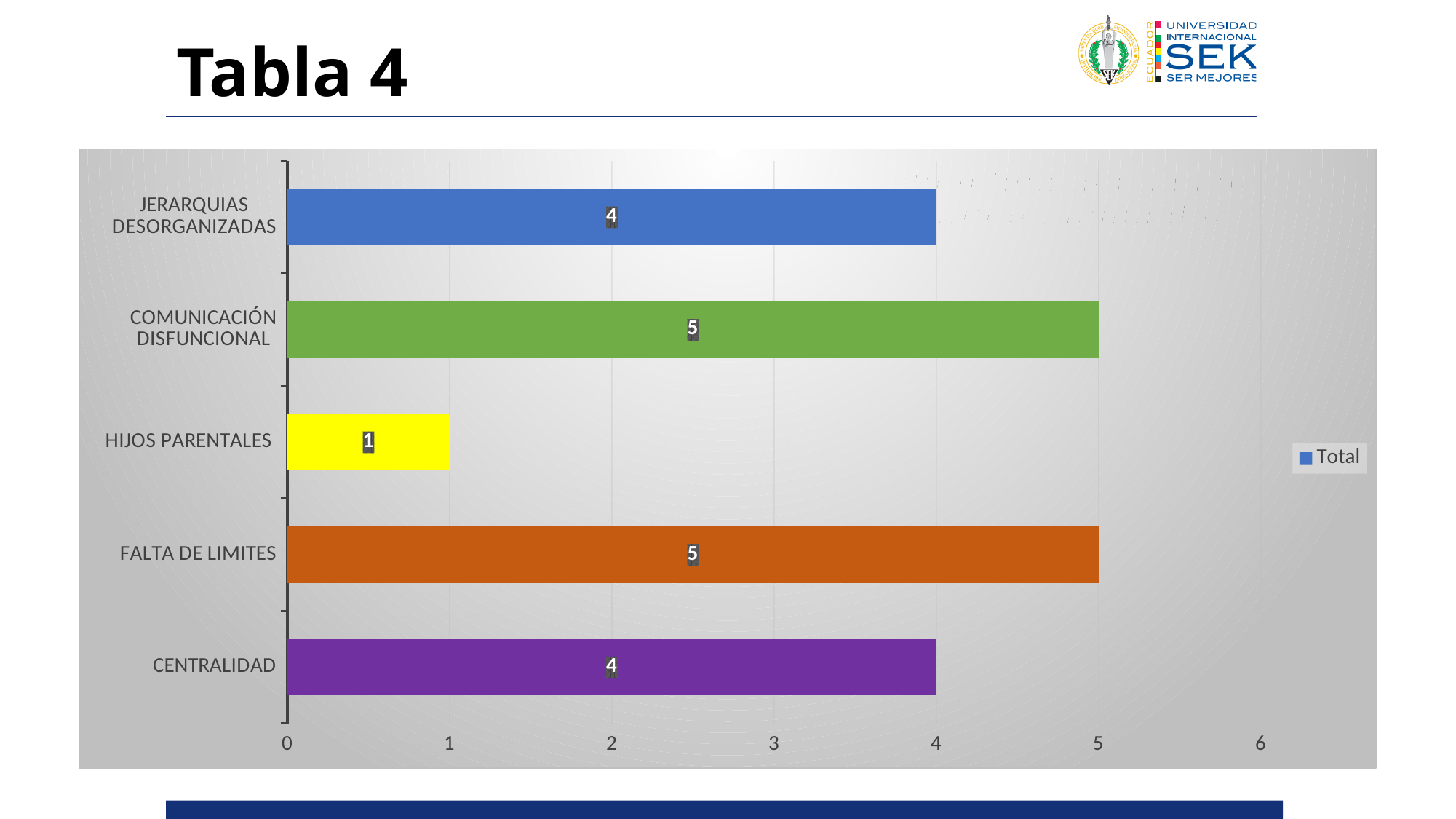
What is the value for JERARQUIAS DESORGANIZADAS? 4 What kind of chart is shown on the slide? bar chart Which category has the lowest value? HIJOS PARENTALES What is the name of the series shown in the legend? Total Is the value for FALTA DE LIMITES greater or less than 3? greater How many categories are shown in the chart? 5 Which is larger, the value for COMUNICACIÓN DISFUNCIONAL or the value for CENTRALIDAD? COMUNICACIÓN DISFUNCIONAL How many series does the legend list? 1 What is the value for CENTRALIDAD? 4 What is the value for HIJOS PARENTALES? 1 What is the value for COMUNICACIÓN DISFUNCIONAL? 5 What is the difference between the values for FALTA DE LIMITES and HIJOS PARENTALES? 4